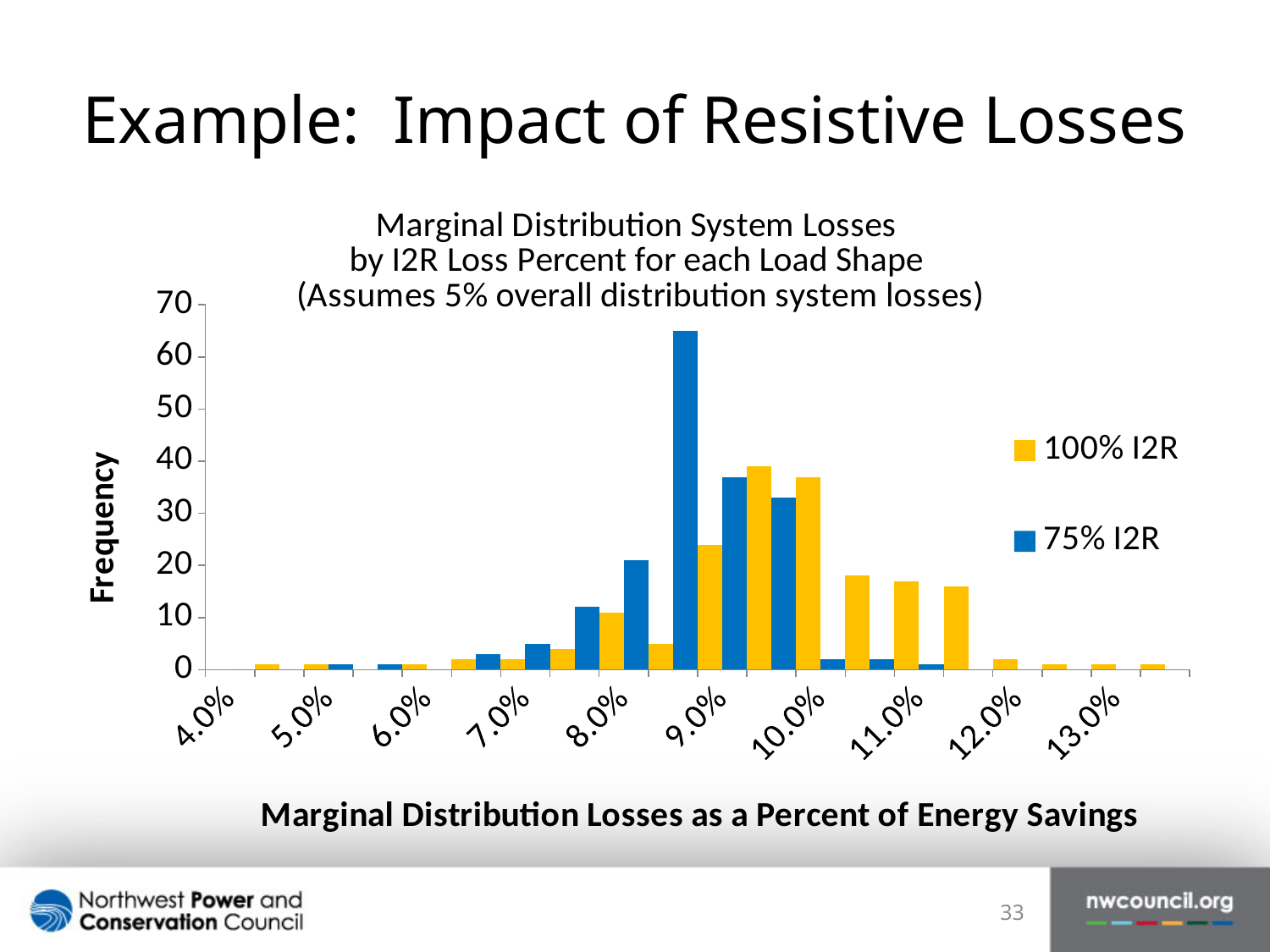
How many series does the legend list? 2 What kind of chart is shown on the slide? bar chart What is the highest value shown on the y axis? 70 Is the tallest 75% I2R bar greater or less than 60? greater Which series is shown in blue? 75% I2R What are the two series named in the legend? 100% I2R and 75% I2R Is the tallest 100% I2R bar greater or less than 30? greater How many percentage labels are shown along the x axis? 10 Which series has the tallest bar in the chart? 75% I2R Is the tallest 100% I2R bar greater or less than 50? less